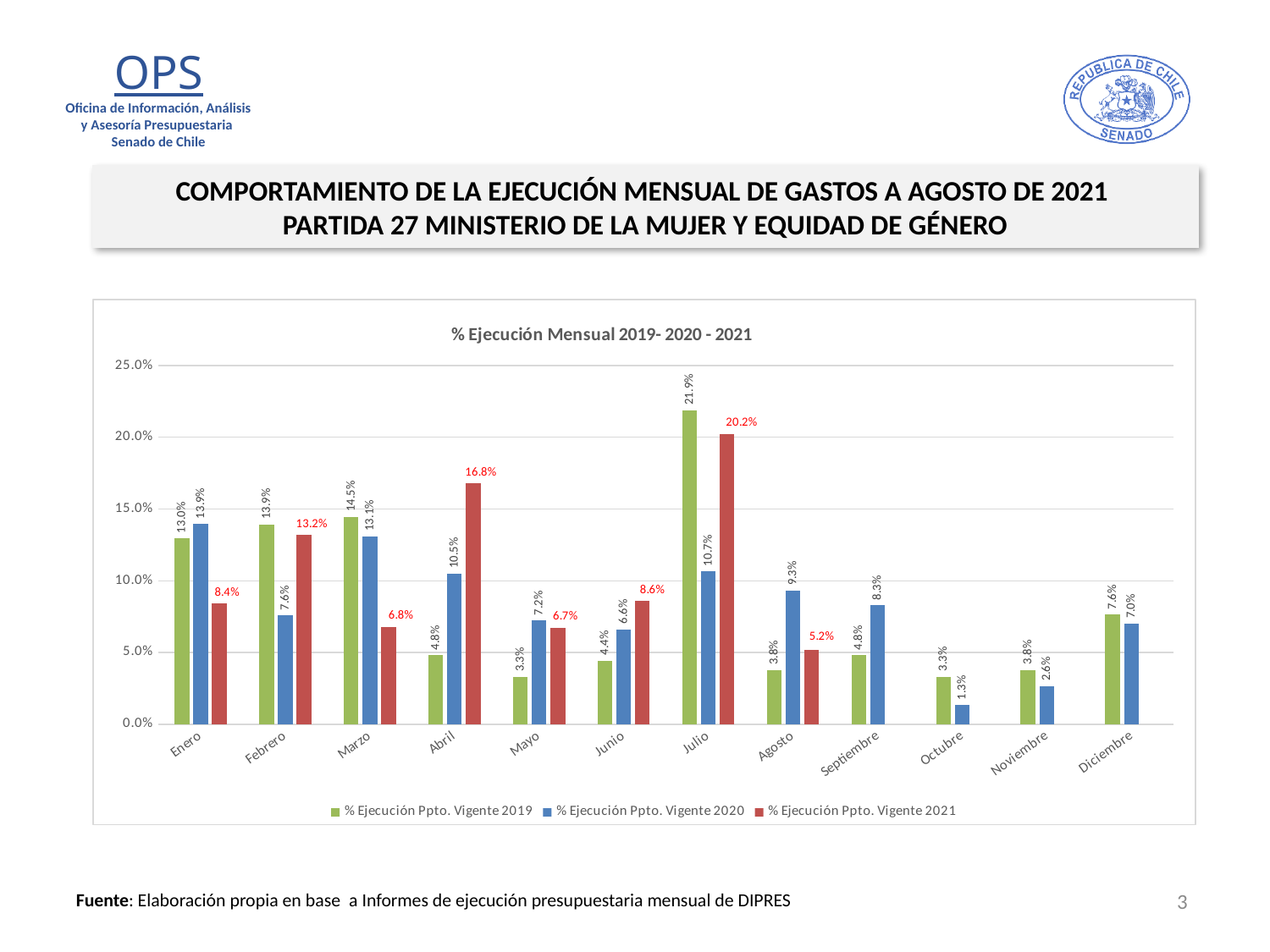
In which month is the % Ejecución Ppto. Vigente 2019 series highest? Julio Is the value for % Ejecución Ppto. Vigente 2019 in Julio greater or less than 20.0%? greater What is the value for % Ejecución Ppto. Vigente 2021 in Julio? 20.2% What is the difference between the 2021 and 2019 values in Abril? 12.0% Which is larger in Febrero: the 2019 value or the 2020 value? 2019 (13.9%) In which month is the % Ejecución Ppto. Vigente 2020 series lowest? Octubre What kind of chart is shown on the slide? Bar chart What is the value for % Ejecución Ppto. Vigente 2019 in Marzo? 14.5% What is the title of the chart? % Ejecución Mensual 2019- 2020 - 2021 How many series does the legend list? 3 What is the value for % Ejecución Ppto. Vigente 2020 in Abril? 10.5% How many months are shown on the x axis? 12